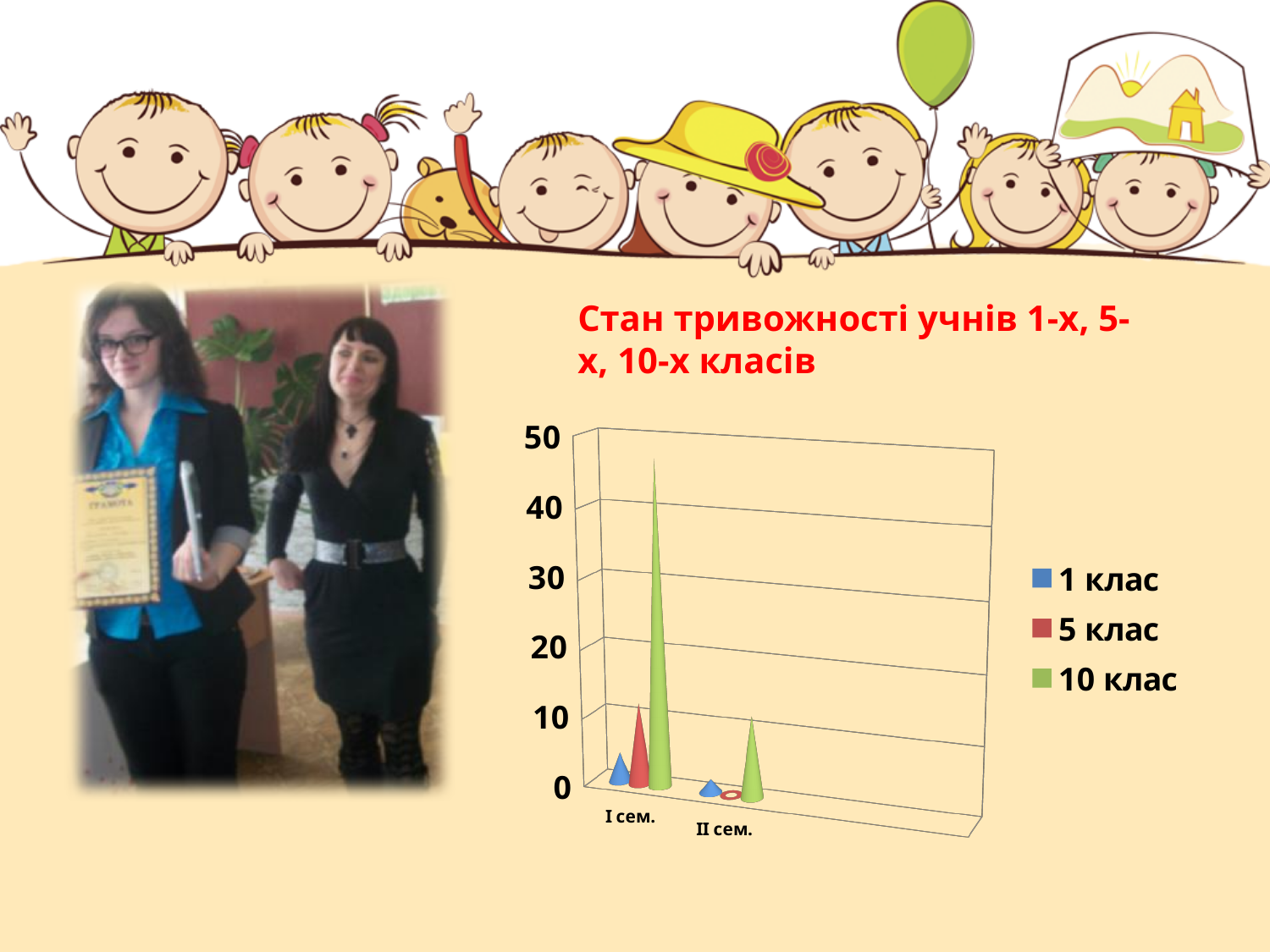
Which series has the lowest value in I сем.? 1 клас How many series does the legend list? 3 Which series has the highest value in I сем.? 10 клас How many categories are shown on the x axis? 2 Is the value for 1 клас in I сем. greater or less than 10? less What kind of chart is shown on the slide? bar chart What is the title of the chart? Стан тривожності учнів 1-х, 5-х, 10-х класів Does the value for 10 клас rise or fall from I сем. to II сем.? fall Is the value for 10 клас in I сем. greater or less than 40? greater Which series has the highest value in II сем.? 10 клас Is the value for 10 клас in II сем. greater or less than 20? less For 10 клас, which is larger: the value in I сем. or in II сем.? I сем.